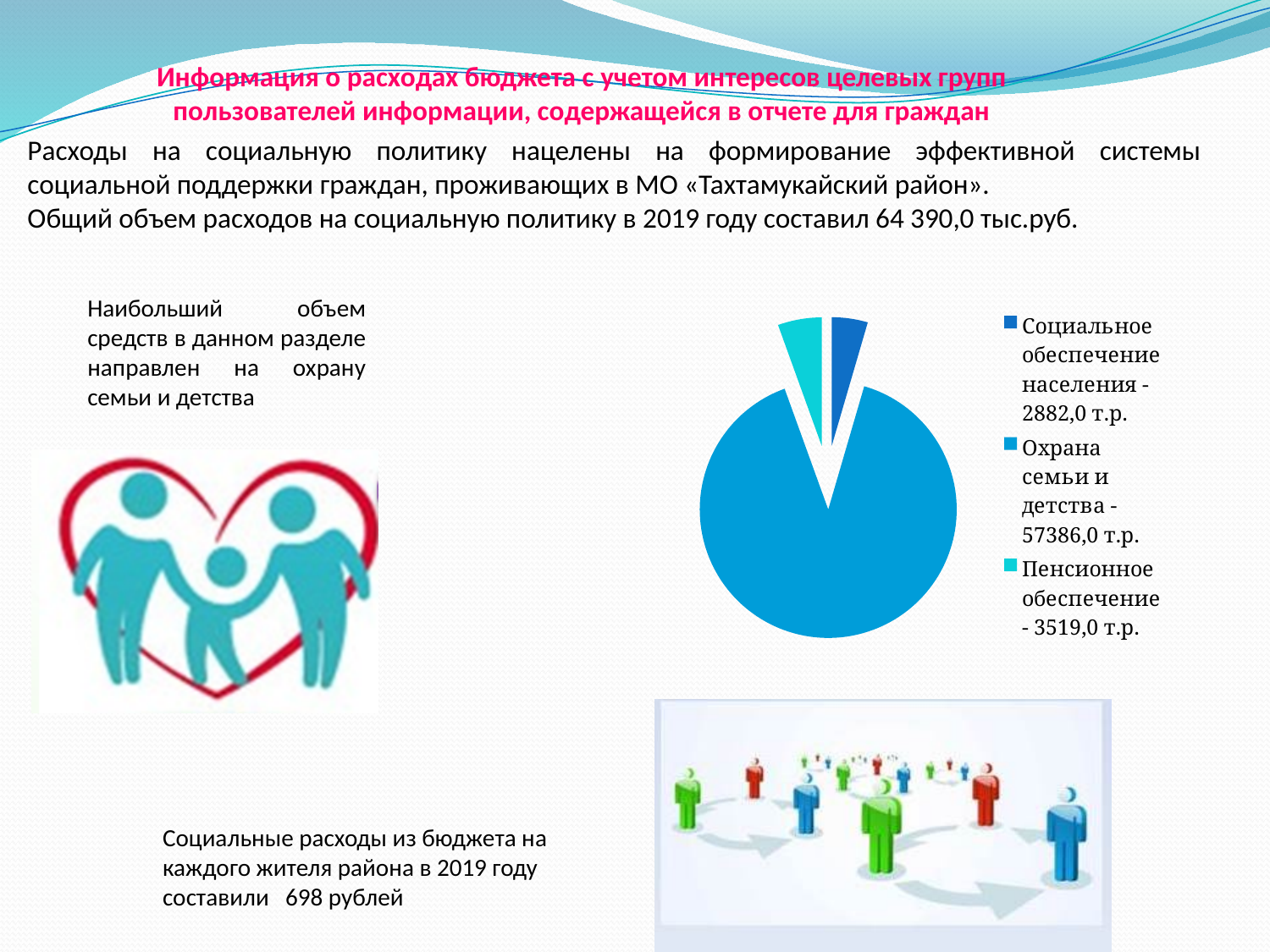
Which category has the smallest slice in the pie chart? Социальное обеспечение населения How many slices does the pie chart have? 3 What is the value for Социальное обеспечение населения in the pie chart? 2882,0 т.р. Which category has the largest slice in the pie chart? Охрана семьи и детства What is the difference between Охрана семьи и детства and Пенсионное обеспечение in the pie chart? 53867,0 т.р. What kind of chart is shown on the slide? pie chart What is the value for Пенсионное обеспечение in the pie chart? 3519,0 т.р. What colour is the slice for Охрана семьи и детства in the pie chart? blue What is the value for Охрана семьи и детства in the pie chart? 57386,0 т.р. Which is larger in the pie chart: Пенсионное обеспечение or Социальное обеспечение населения? Пенсионное обеспечение What is the difference between Пенсионное обеспечение and Социальное обеспечение населения in the pie chart? 637,0 т.р. How many entries does the legend of the pie chart list? 3